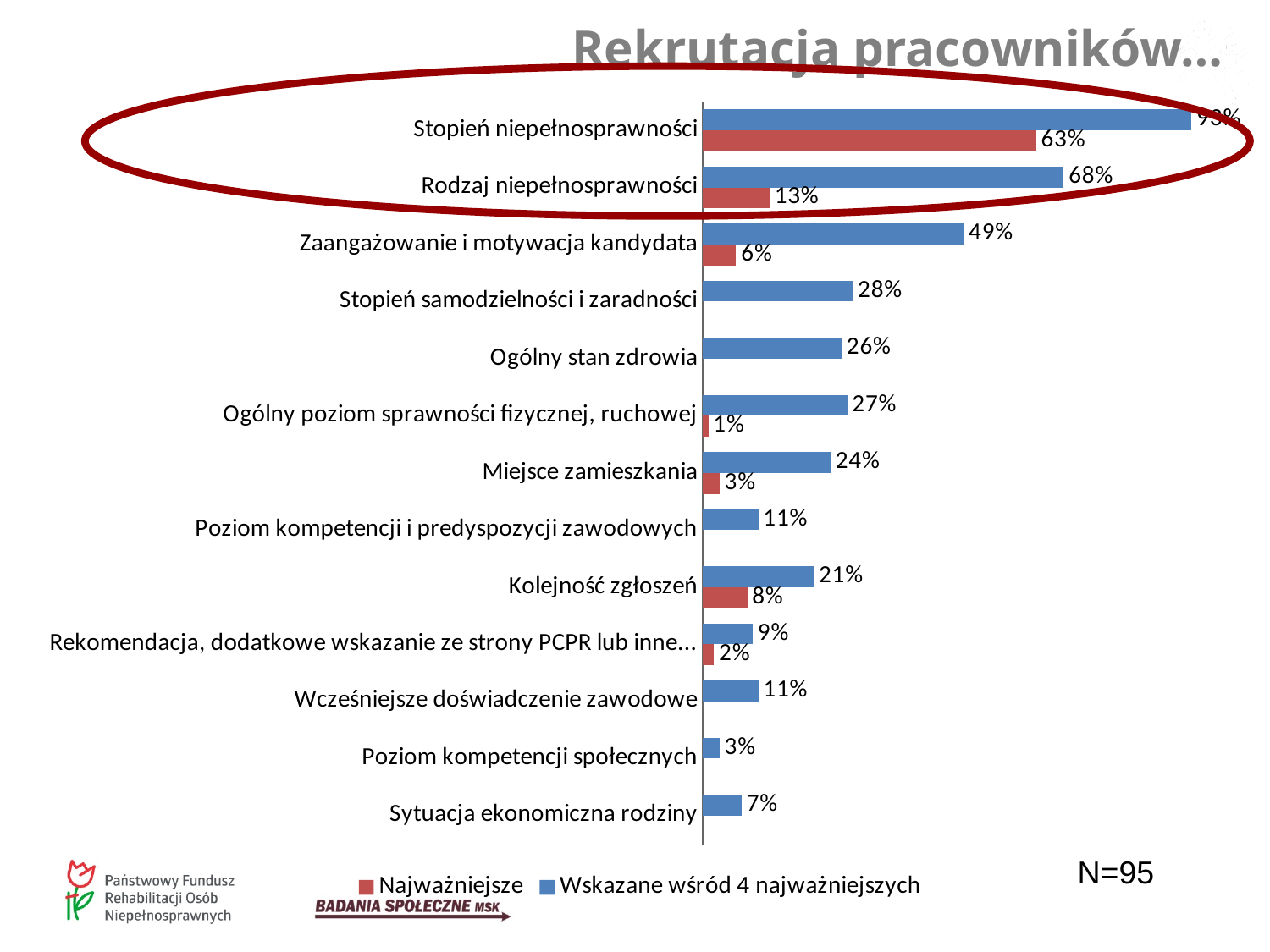
How many categories are shown on the chart? 13 In the "Wskazane wśród 4 najważniejszych" series, which is larger: "Stopień samodzielności i zaradności" or "Miejsce zamieszkania"? Stopień samodzielności i zaradności Which category has the highest value in the "Najważniejsze" series? Stopień niepełnosprawności What is the value of the "Najważniejsze" series for "Stopień niepełnosprawności"? 63% What is the value of the "Wskazane wśród 4 najważniejszych" series for "Rodzaj niepełnosprawności"? 68% What sample size (N) is stated on the slide? N=95 For "Rodzaj niepełnosprawności", what is the difference between the "Wskazane wśród 4 najważniejszych" value and the "Najważniejsze" value? 55 percentage points How many series does the legend list? 2 What type of chart is shown on the slide? Bar chart What is the value of the "Najważniejsze" series for "Rodzaj niepełnosprawności"? 13% Which category has the lowest value in the "Wskazane wśród 4 najważniejszych" series? Poziom kompetencji społecznych What is the value of the "Wskazane wśród 4 najważniejszych" series for "Zaangażowanie i motywacja kandydata"? 49%